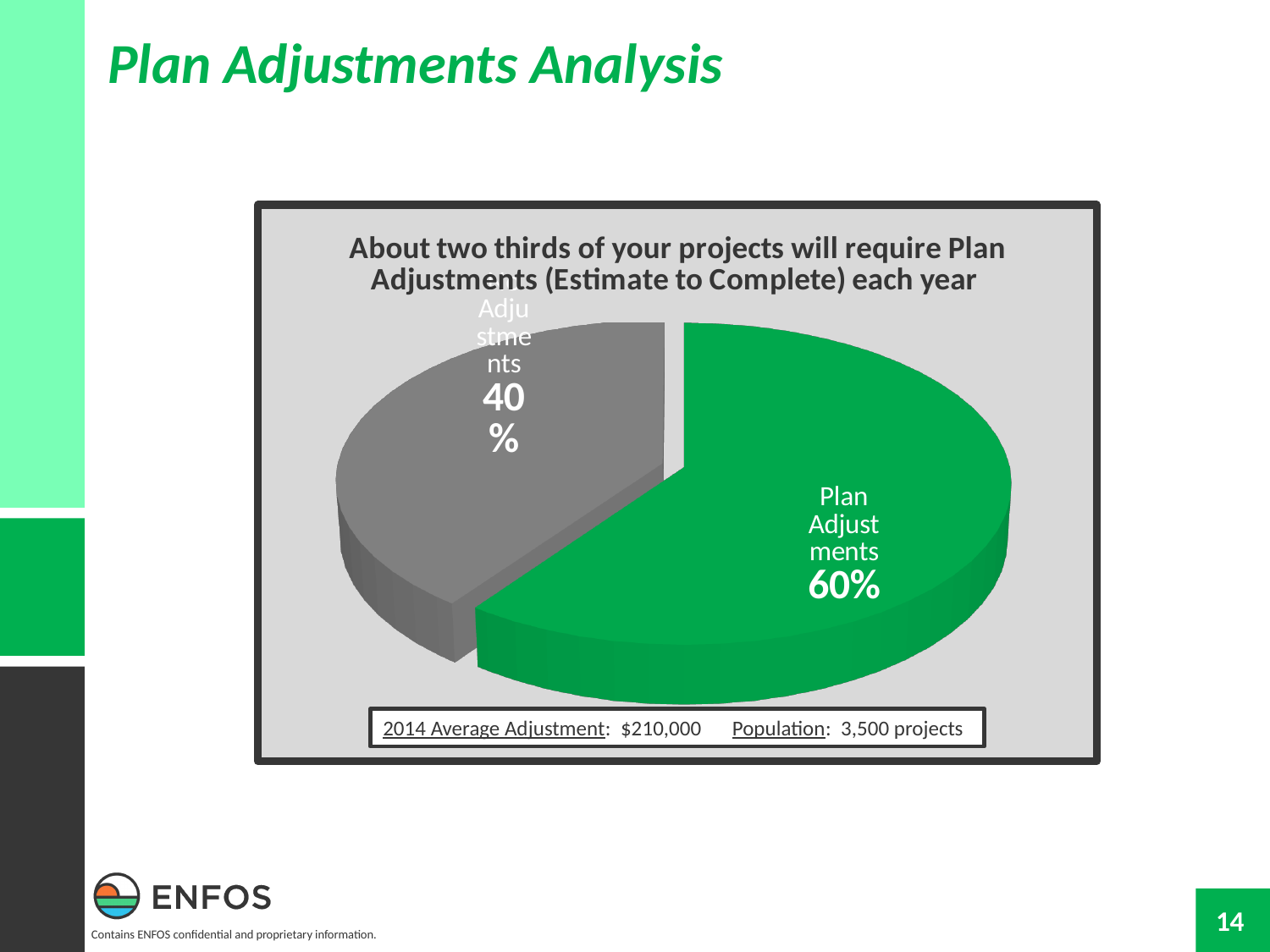
How many slices does the pie chart have? 2 What is the difference in percentage points between the Plan Adjustments slice and the grey slice? 20 According to the text box below the pie chart, what was the 2014 Average Adjustment? $210,000 According to the text box below the pie chart, what is the population size? 3,500 projects What colour is the Plan Adjustments slice of the pie chart? green Which slice of the pie chart is the largest? Plan Adjustments What share of the pie does the Plan Adjustments slice represent? 60% Which is larger, the Plan Adjustments slice or the grey slice? Plan Adjustments What kind of chart is shown on the slide? pie chart What percentage is shown on the grey slice of the pie chart? 40% What is the title of the pie chart? About two thirds of your projects will require Plan Adjustments (Estimate to Complete) each year